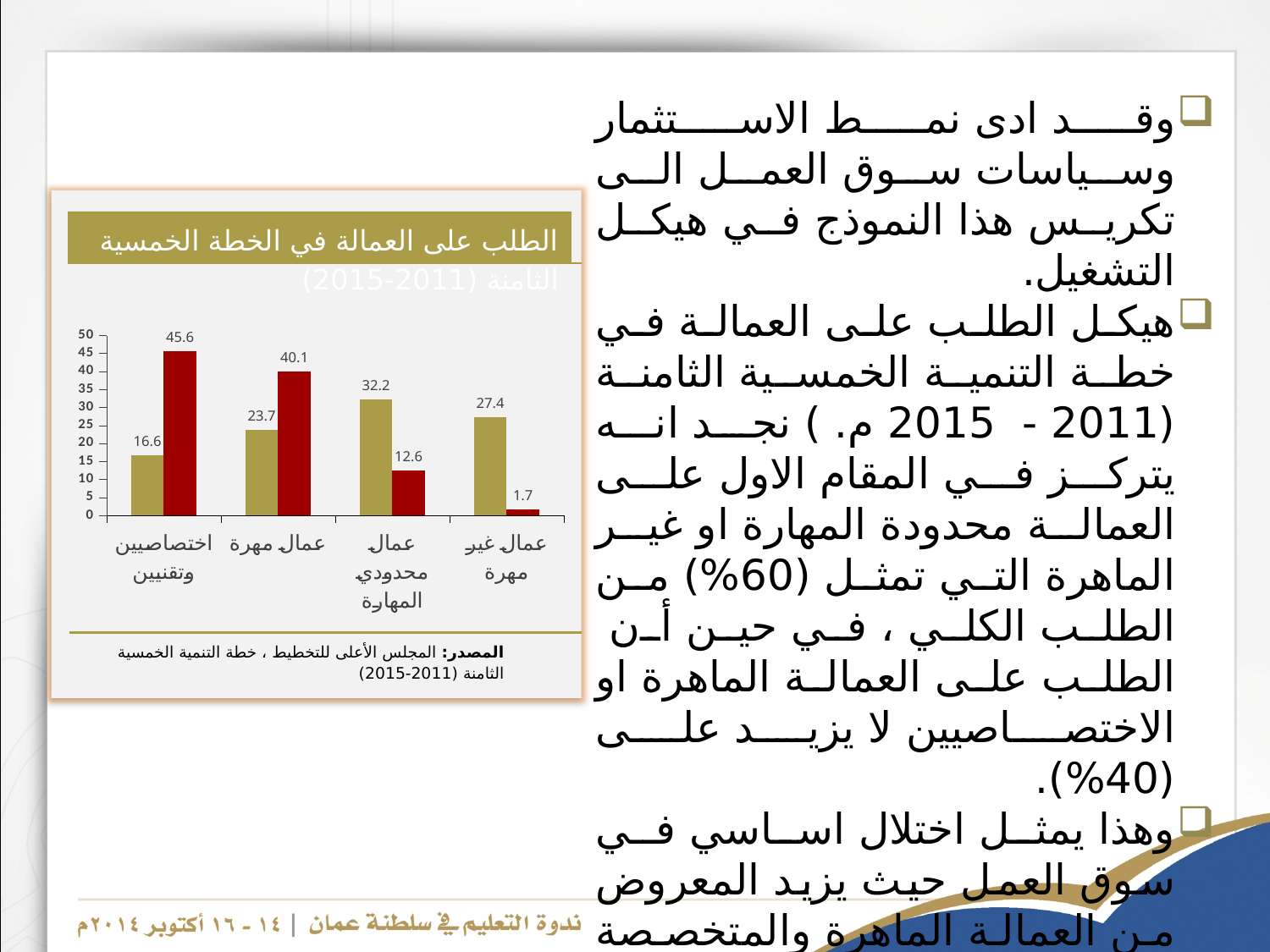
What is the title of the chart on the slide? الطلب على العمالة في الخطة الخمسية الثامنة (2011-2015) How many categories are shown on the x axis of the chart? 4 What type of chart is shown on the slide? bar chart Which category has the highest red bar? اختصاصيين وتقنيين What is the value of the gold bar for عمال غير مهرة? 27.4 What is the value of the gold bar for عمال مهرة? 23.7 What is the difference between the red bar and the gold bar for اختصاصيين وتقنيين? 29.0 What is the value of the red bar for عمال محدودي المهارة? 12.6 Which category has the lowest red bar? عمال غير مهرة What is the value of the red bar for اختصاصيين وتقنيين? 45.6 Which category has the highest gold bar? عمال محدودي المهارة For عمال غير مهرة, which is larger: the gold bar or the red bar? the gold bar